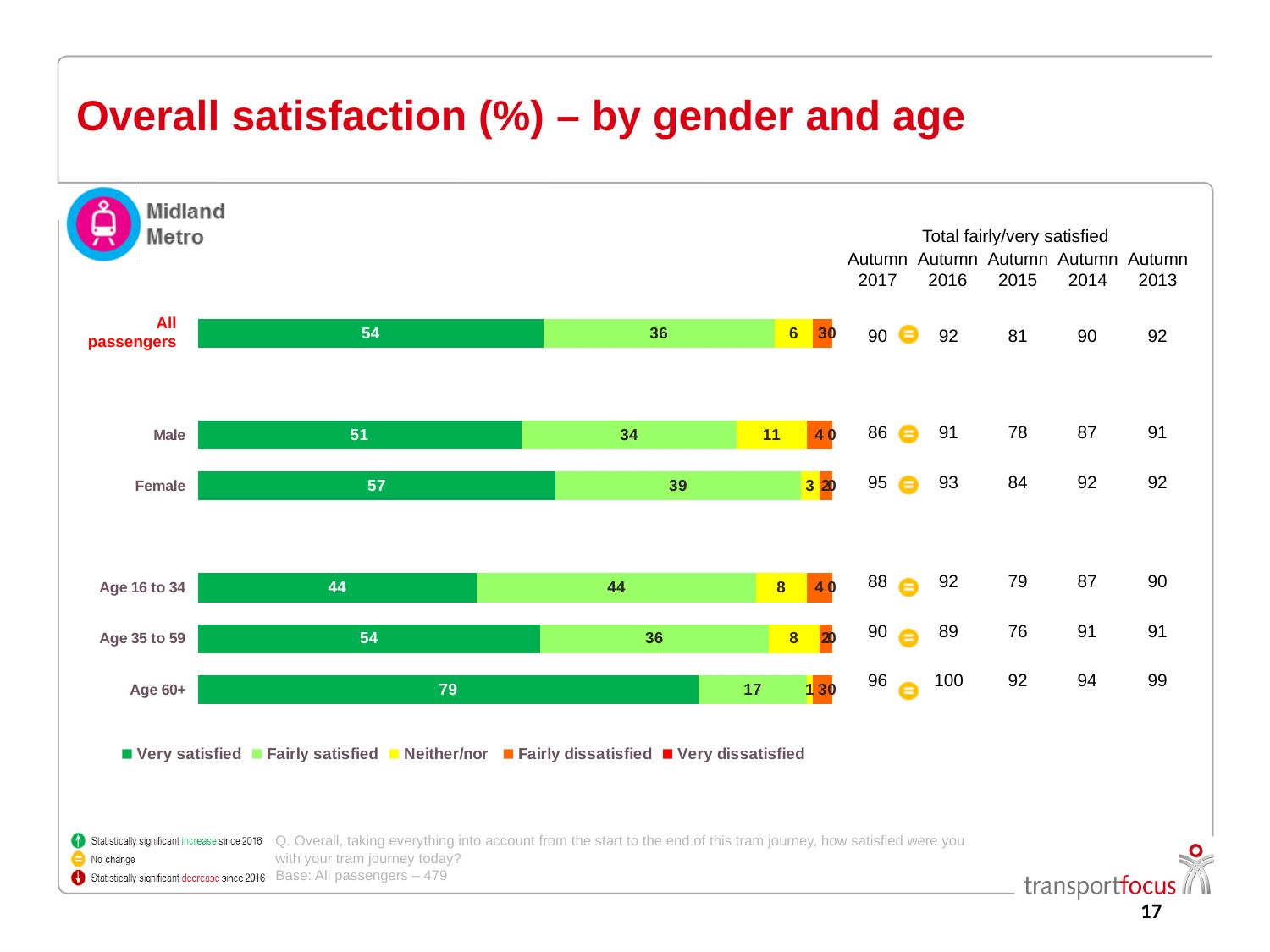
How many series does the legend list? 5 How many categories (bars) are plotted in the chart? 6 What is the difference between the Very satisfied values for Female and Male passengers? 6 What is the Fairly satisfied value for Female passengers? 39 What is the Very satisfied value for Age 60+? 79 Which legend entry is shown in yellow? Neither/nor What is the Neither/nor value for Male passengers? 11 What kind of chart is shown on the slide? Stacked bar chart Which is larger, the Fairly satisfied value for Age 16 to 34 or for Age 35 to 59? Age 16 to 34 Which category has the lowest Very satisfied value? Age 16 to 34 What is the combined Very satisfied and Fairly satisfied value for All passengers? 90 Which category has the highest Very satisfied value? Age 60+